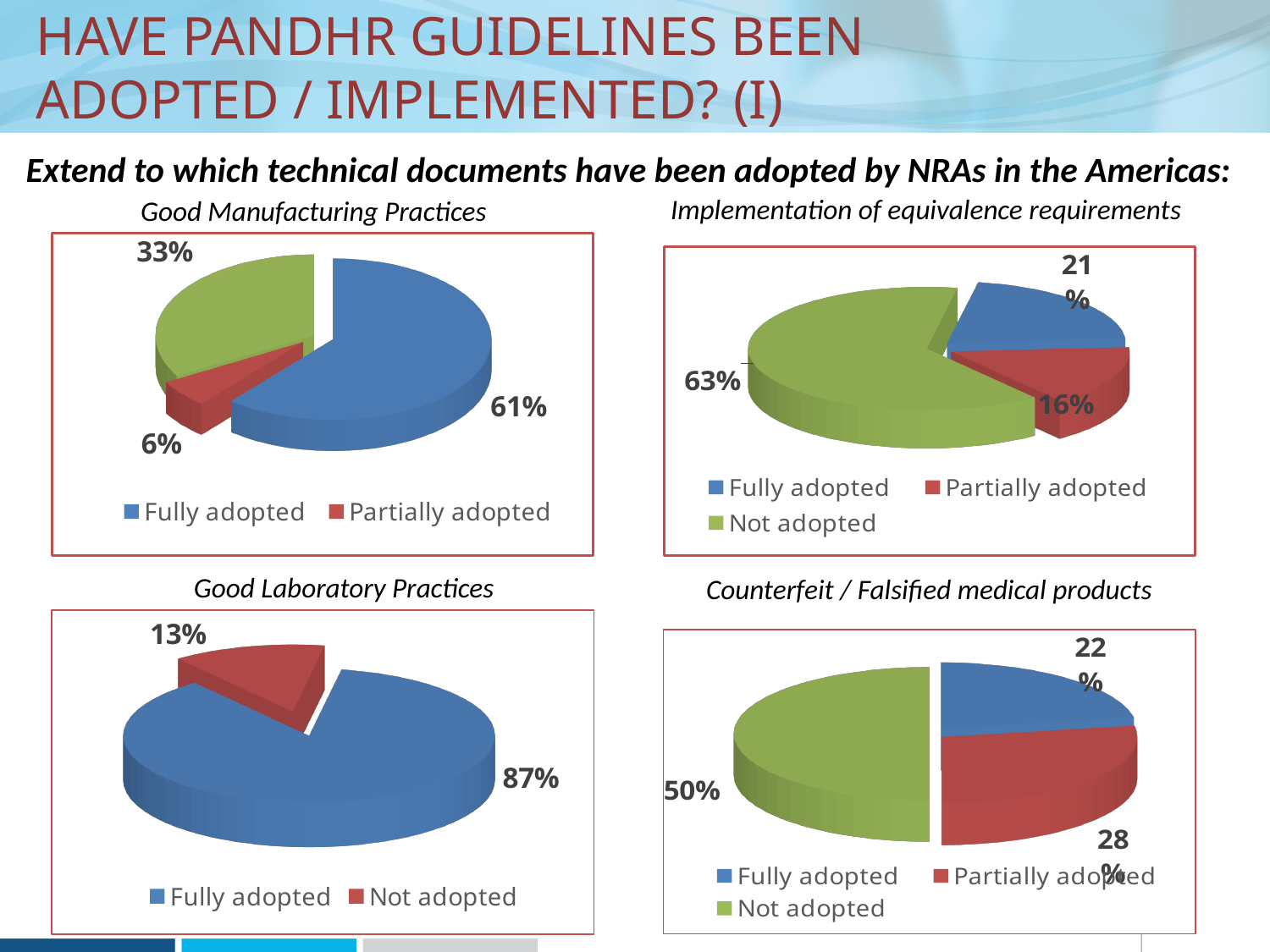
In the Counterfeit / Falsified medical products chart, which is larger, Fully adopted or Partially adopted? Partially adopted What type of chart is the Good Laboratory Practices chart? Pie chart In the Good Laboratory Practices chart, what is the difference between Fully adopted and Not adopted? 74% In the Implementation of equivalence requirements chart, what share is Not adopted? 63% In the Good Laboratory Practices chart, what share is Fully adopted? 87% How many charts are shown on the slide? 4 In the Counterfeit / Falsified medical products chart, how many categories does the legend list? 3 In the Good Manufacturing Practices chart, what share is Partially adopted? 6% In the Counterfeit / Falsified medical products chart, what share is Not adopted? 50% In the Implementation of equivalence requirements chart, which category has the smallest slice? Partially adopted In the Implementation of equivalence requirements chart, what share is Fully adopted? 21% In the Good Manufacturing Practices chart, what share is Fully adopted? 61%